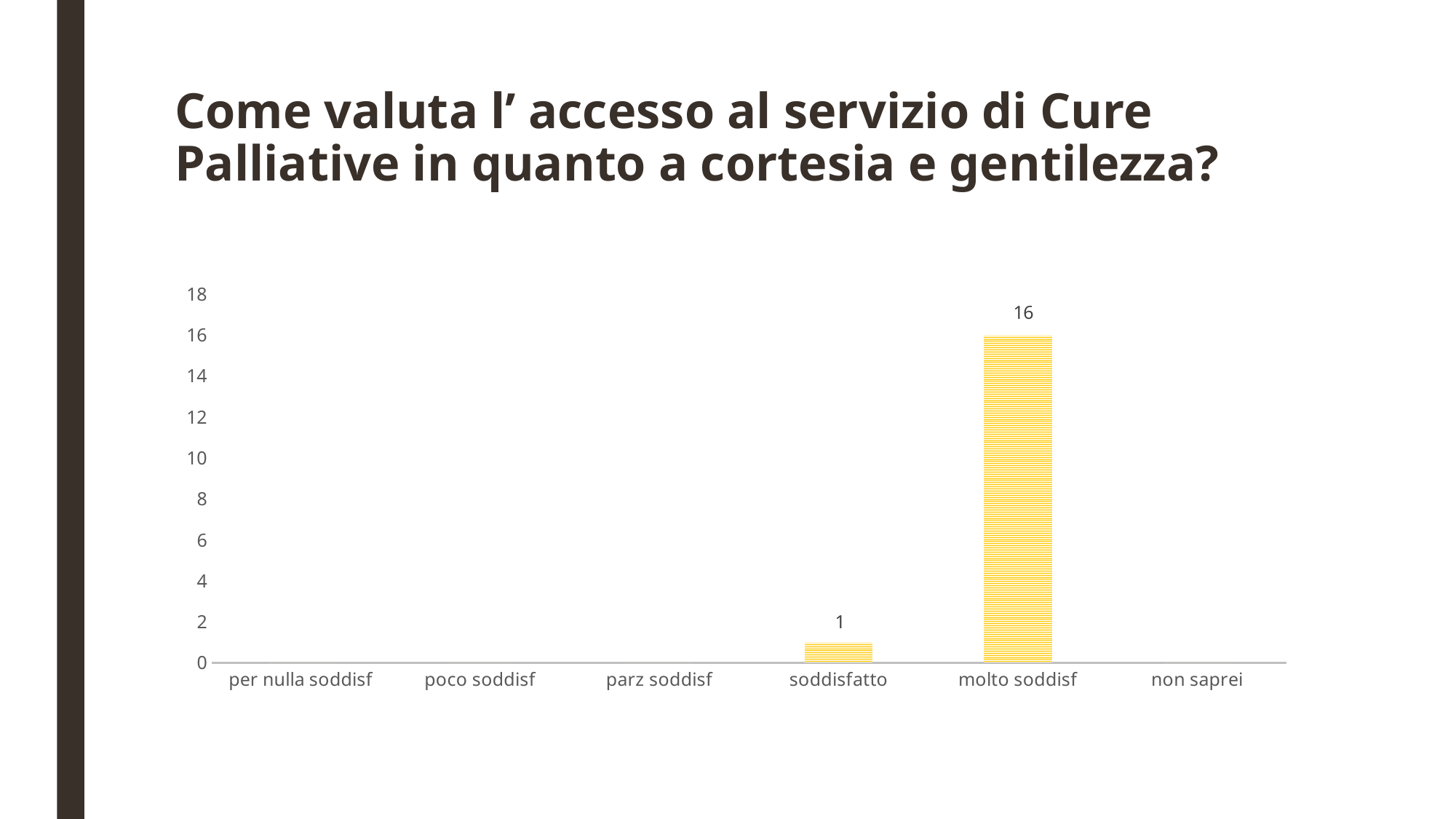
How many categories are shown on the x axis? 6 What is the label of the last category on the x axis? non saprei What is the highest value shown on the y axis? 18 What is the value for "soddisfatto"? 1 Which is larger, the value for "soddisfatto" or the value for "molto soddisf"? molto soddisf What is the value for "molto soddisf"? 16 How many categories have a visible bar? 2 What kind of chart is shown on the slide? bar chart Is the value for "molto soddisf" greater or less than 10? greater Which category has the highest value? molto soddisf What is the difference between the values for "molto soddisf" and "soddisfatto"? 15 Is the value for "soddisfatto" greater or less than 4? less